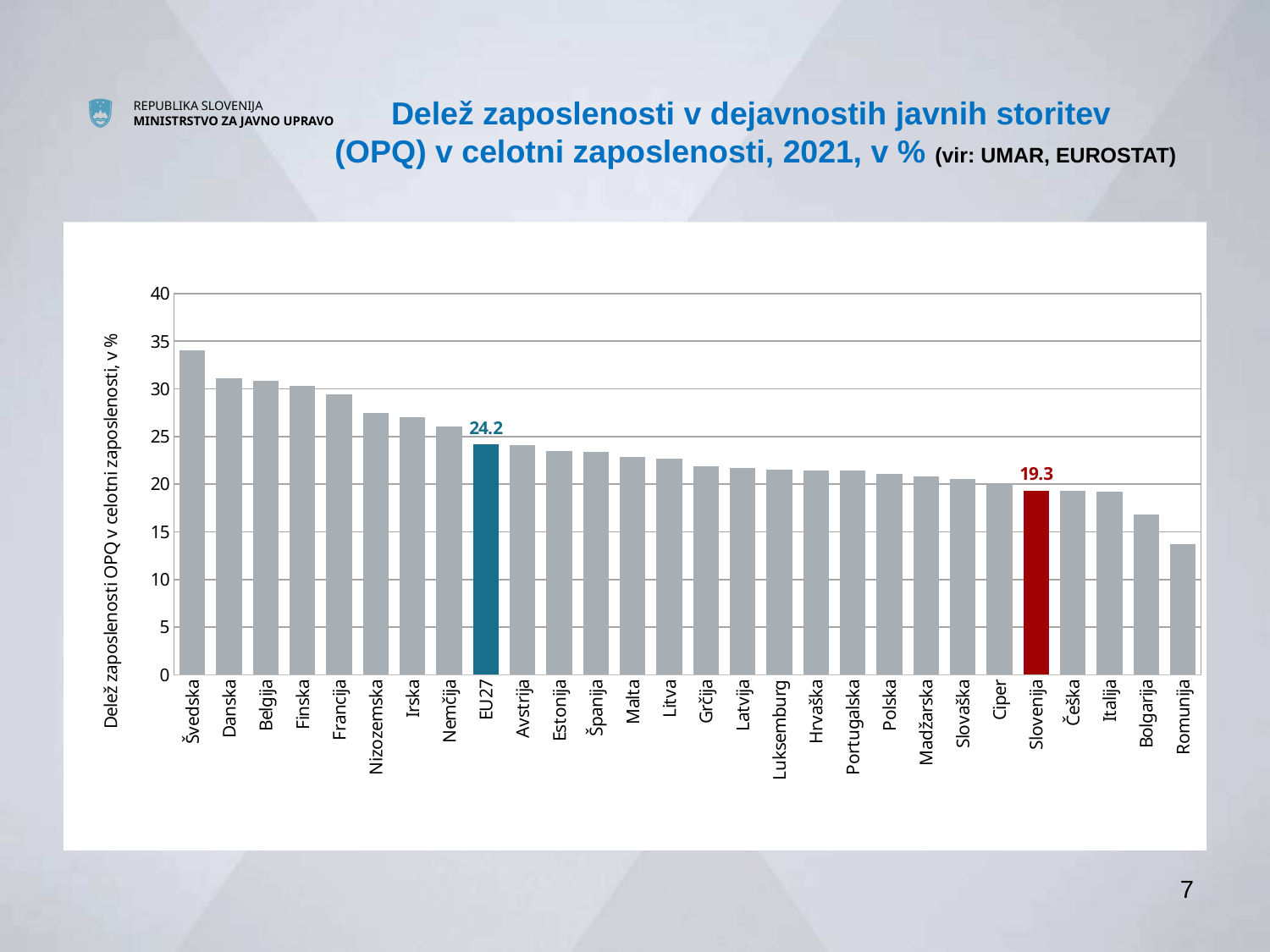
Which country has the highest share? Švedska Which of EU27 or Slovenija has the larger value? EU27 Is the value for Francija greater or less than 25? greater What is the difference between the EU27 value and the Slovenija value? 4.9 How many bars are shown in the chart? 28 Is the value for Švedska greater or less than 30? greater What is the value shown for EU27? 24.2 Do the values rise or fall from left to right along the x axis? Fall Is the value for Romunija greater or less than 15? less What is the value shown for Slovenija? 19.3 What kind of chart is shown on the slide? Bar chart Which country has the lowest share? Romunija